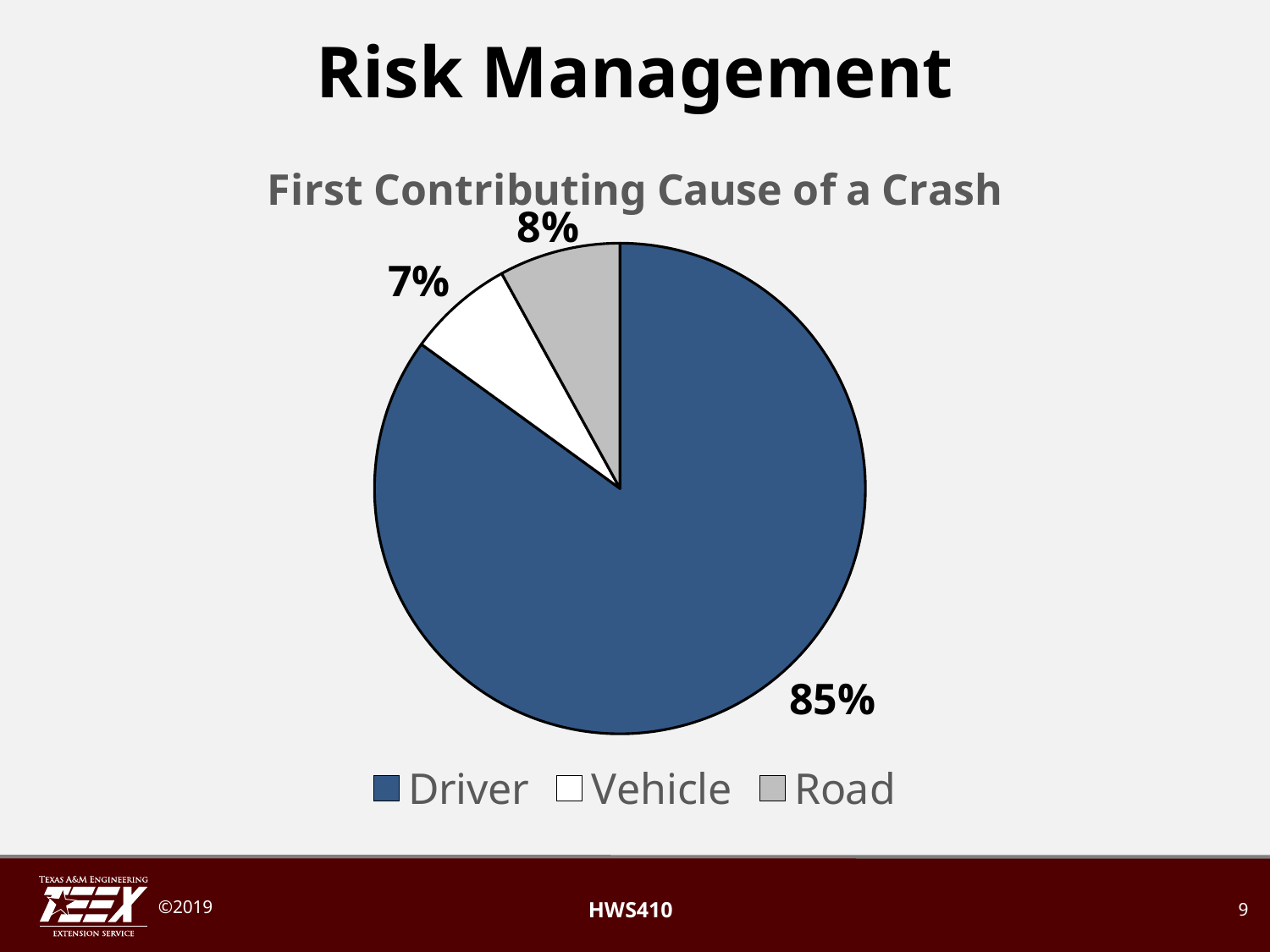
What share of the pie does Road account for? 8% What is the difference in percentage points between the Road slice and the Vehicle slice? 1 Which category has the smallest slice of the pie? Vehicle Which is larger, the Driver slice or the Vehicle slice? Driver What kind of chart is shown on the slide? Pie chart How many categories are shown in the pie chart? 3 What is the title of the chart? First Contributing Cause of a Crash What share of the pie does Vehicle account for? 7% What share of the pie does Driver account for? 85% Which category is shown in blue in the legend? Driver What is the difference in percentage points between the Driver slice and the Road slice? 77 Which category has the largest slice of the pie? Driver